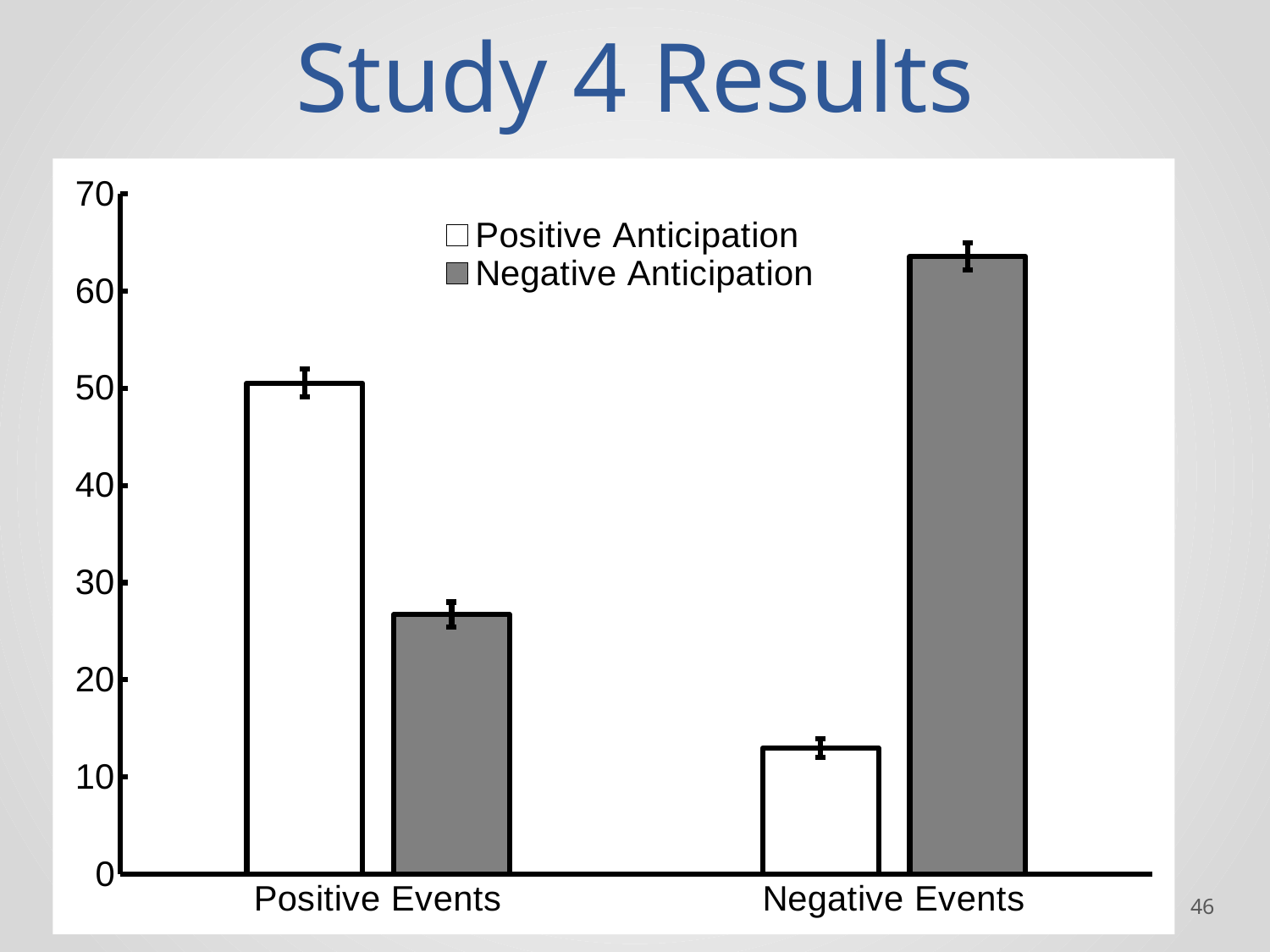
Which bar is the lowest in the chart? Positive Anticipation for Negative Events Which bar is the highest in the chart? Negative Anticipation for Negative Events Is the value for Positive Anticipation for Negative Events greater or less than 20? less Does the Positive Anticipation series rise or fall from Positive Events to Negative Events? fall How many series does the legend list? 2 How many event categories are shown on the x axis? 2 For Positive Events, which is larger: Positive Anticipation or Negative Anticipation? Positive Anticipation For Negative Events, which is larger: Positive Anticipation or Negative Anticipation? Negative Anticipation Is the value for Negative Anticipation for Negative Events greater or less than 60? greater What is the title of the slide containing the chart? Study 4 Results Which series is shown with gray bars? Negative Anticipation What kind of chart is shown on the slide? bar chart